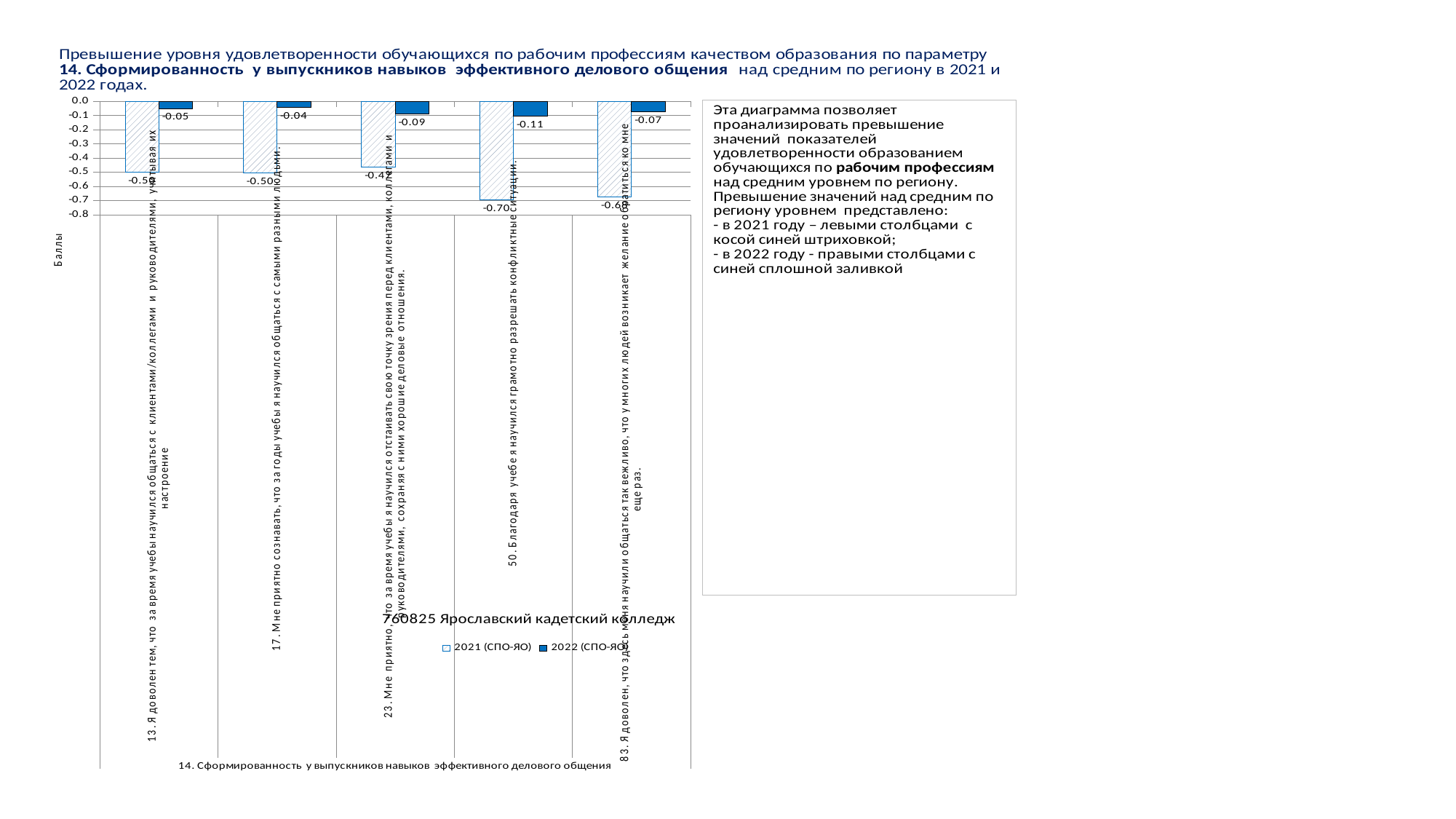
What is the 2022 (СПО-ЯО) value for item 13? -0.05 Which item has the lowest 2021 (СПО-ЯО) value? 50 What kind of chart is shown on the slide? bar chart How many series does the chart legend list? 2 What are the two entries in the chart legend? 2021 (СПО-ЯО) and 2022 (СПО-ЯО) What is the 2021 (СПО-ЯО) value for item 50 (Благодаря учебе я научился грамотно разрешать конфликтные ситуации)? -0.70 Is the 2021 (СПО-ЯО) value for item 23 greater or less than -0.4? less What is the 2022 (СПО-ЯО) value for item 50 (Благодаря учебе я научился грамотно разрешать конфликтные ситуации)? -0.11 What is the 2022 (СПО-ЯО) value for item 17? -0.04 Which item has the lowest 2022 (СПО-ЯО) value? 50 What is the difference between the 2021 and 2022 values for item 50? 0.59 How many categories (questionnaire items) are plotted on the chart? 5